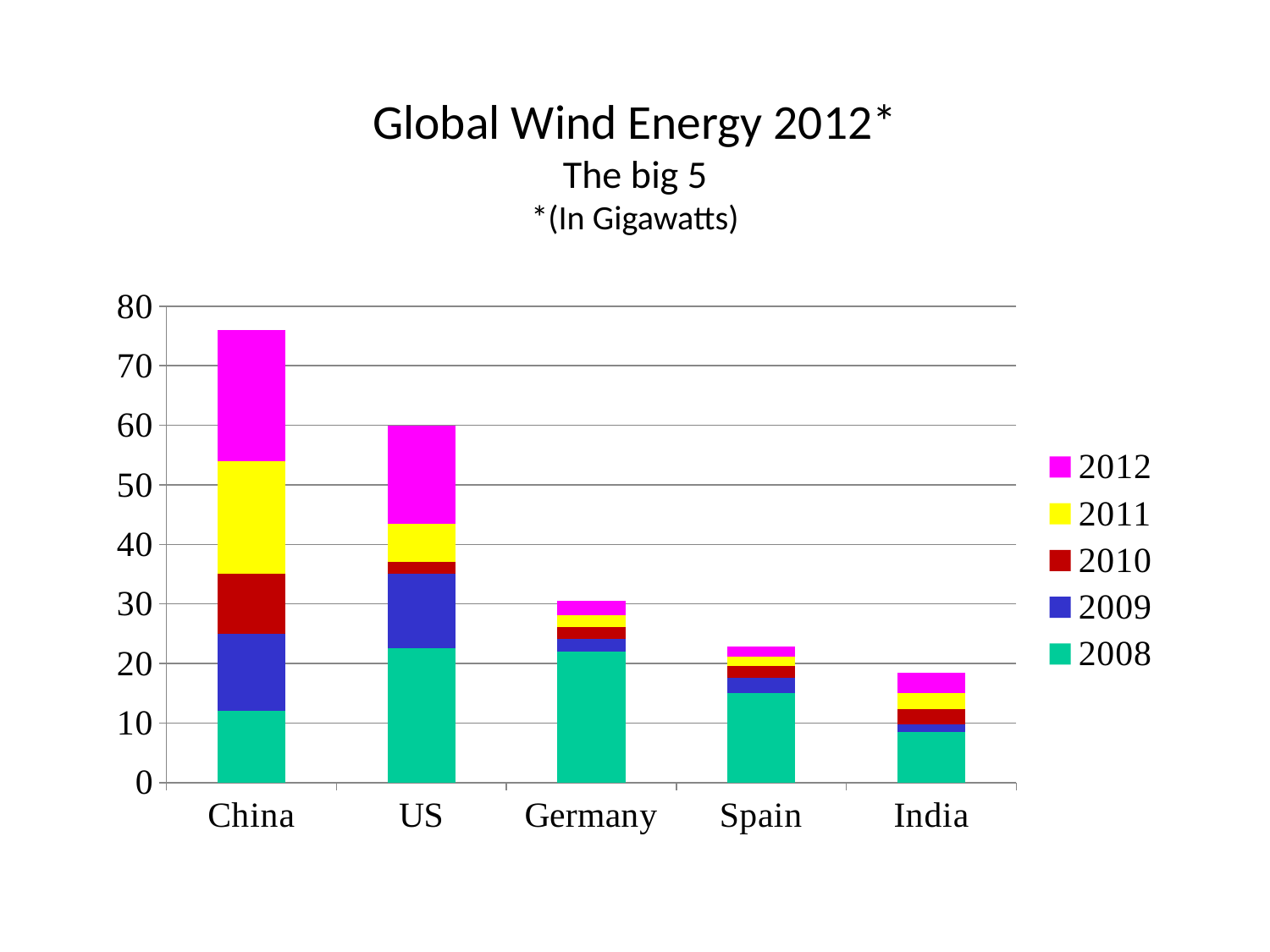
Is the total stacked bar for China greater or less than 70? greater Which has the taller stacked bar, US or Germany? US Which country has the tallest stacked bar? China Is the 2008 segment for China greater or less than 10? greater Which country has the larger 2008 segment, China or US? US How many series does the legend list? 5 What is the title of the chart on the slide? Global Wind Energy 2012* What kind of chart is shown on the slide? stacked bar chart Is the total stacked bar for India greater or less than 20? less How many countries are shown on the x axis of the chart? 5 Which country has the shortest stacked bar? India